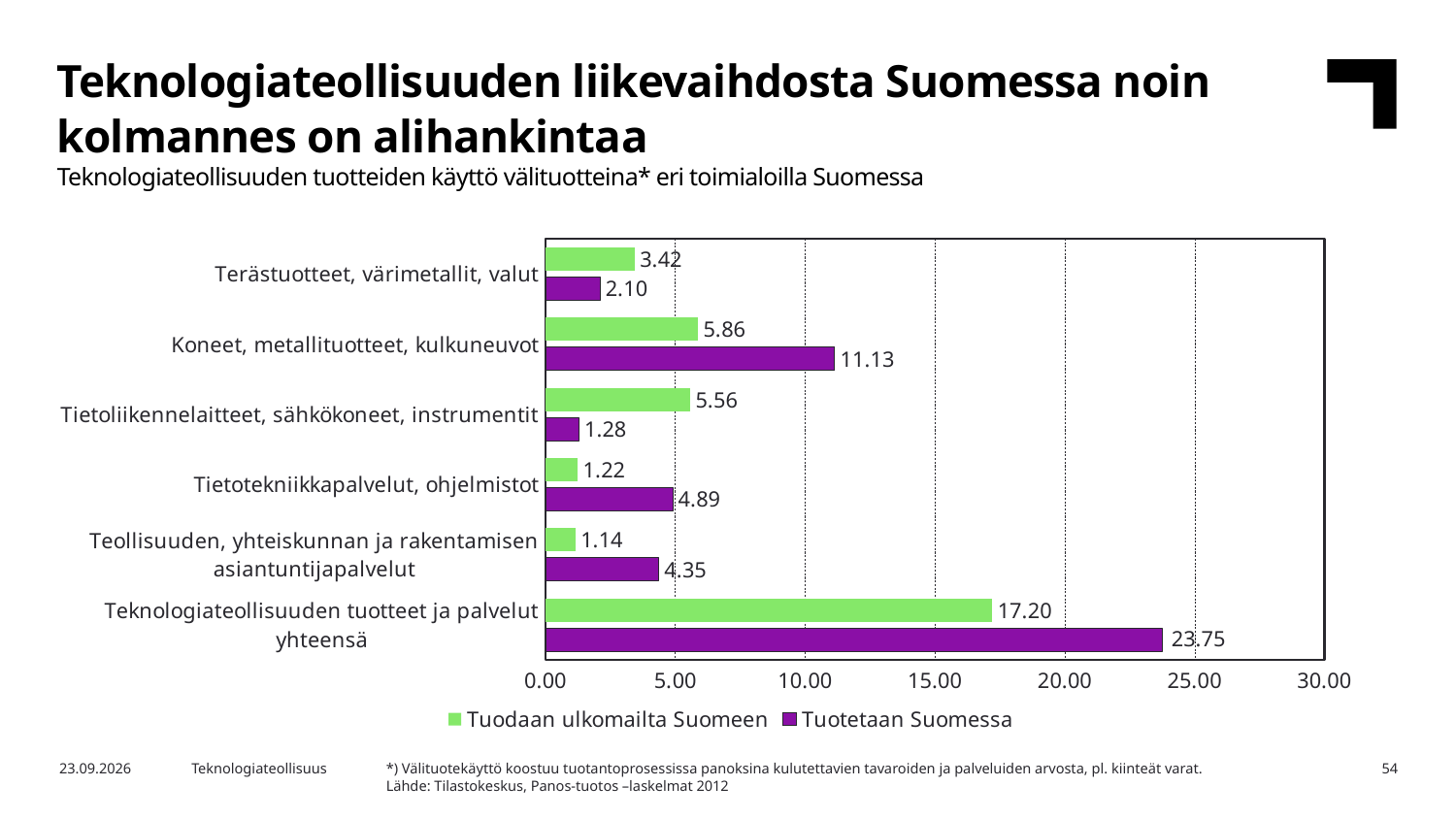
What is the value of "Tuodaan ulkomailta Suomeen" for Tietoliikennelaitteet, sähkökoneet, instrumentit? 5.56 Is the "Tuotetaan Suomessa" value for Teknologiateollisuuden tuotteet ja palvelut yhteensä greater or less than 20.00? greater For Tietotekniikkapalvelut, ohjelmistot, which is larger: "Tuodaan ulkomailta Suomeen" or "Tuotetaan Suomessa"? Tuotetaan Suomessa How many series does the legend list? 2 Excluding the total row (yhteensä), which category has the highest "Tuotetaan Suomessa" value? Koneet, metallituotteet, kulkuneuvot What is the value of "Tuotetaan Suomessa" for Teknologiateollisuuden tuotteet ja palvelut yhteensä? 23.75 What is the difference between the "Tuotetaan Suomessa" and "Tuodaan ulkomailta Suomeen" values for Koneet, metallituotteet, kulkuneuvot? 5.27 What type of chart is shown on the slide? Bar chart What is the value of "Tuodaan ulkomailta Suomeen" for Terästuotteet, värimetallit, valut? 3.42 Which category has the lowest "Tuodaan ulkomailta Suomeen" value? Teollisuuden, yhteiskunnan ja rakentamisen asiantuntijapalvelut How many categories are shown on the chart? 6 What is the value of "Tuotetaan Suomessa" for Koneet, metallituotteet, kulkuneuvot? 11.13